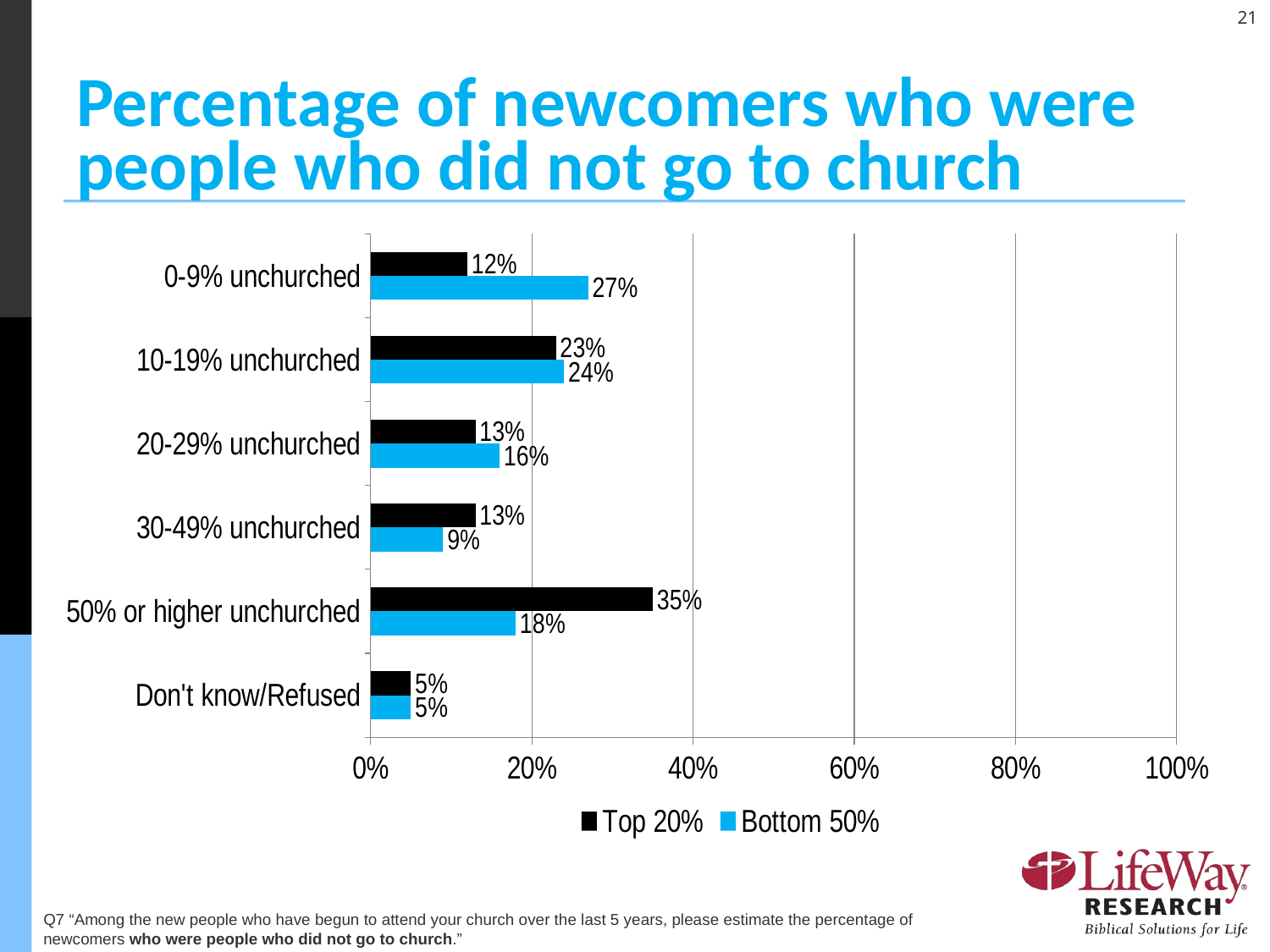
Which category has the highest Top 20% value? 50% or higher unchurched What is the Bottom 50% value for 0-9% unchurched? 27% For 0-9% unchurched, which series has the larger value, Top 20% or Bottom 50%? Bottom 50% What is the Top 20% value for 50% or higher unchurched? 35% Which colour represents the Bottom 50% series? blue What is the difference between the Top 20% and Bottom 50% values for 50% or higher unchurched? 17% Which category has the lowest Bottom 50% value? Don't know/Refused Is the Top 20% value for 50% or higher unchurched greater or less than 20%? greater How many categories are shown on the chart? 6 How many series does the legend list? 2 What is the Bottom 50% value for 30-49% unchurched? 9% What kind of chart is shown on the slide? bar chart